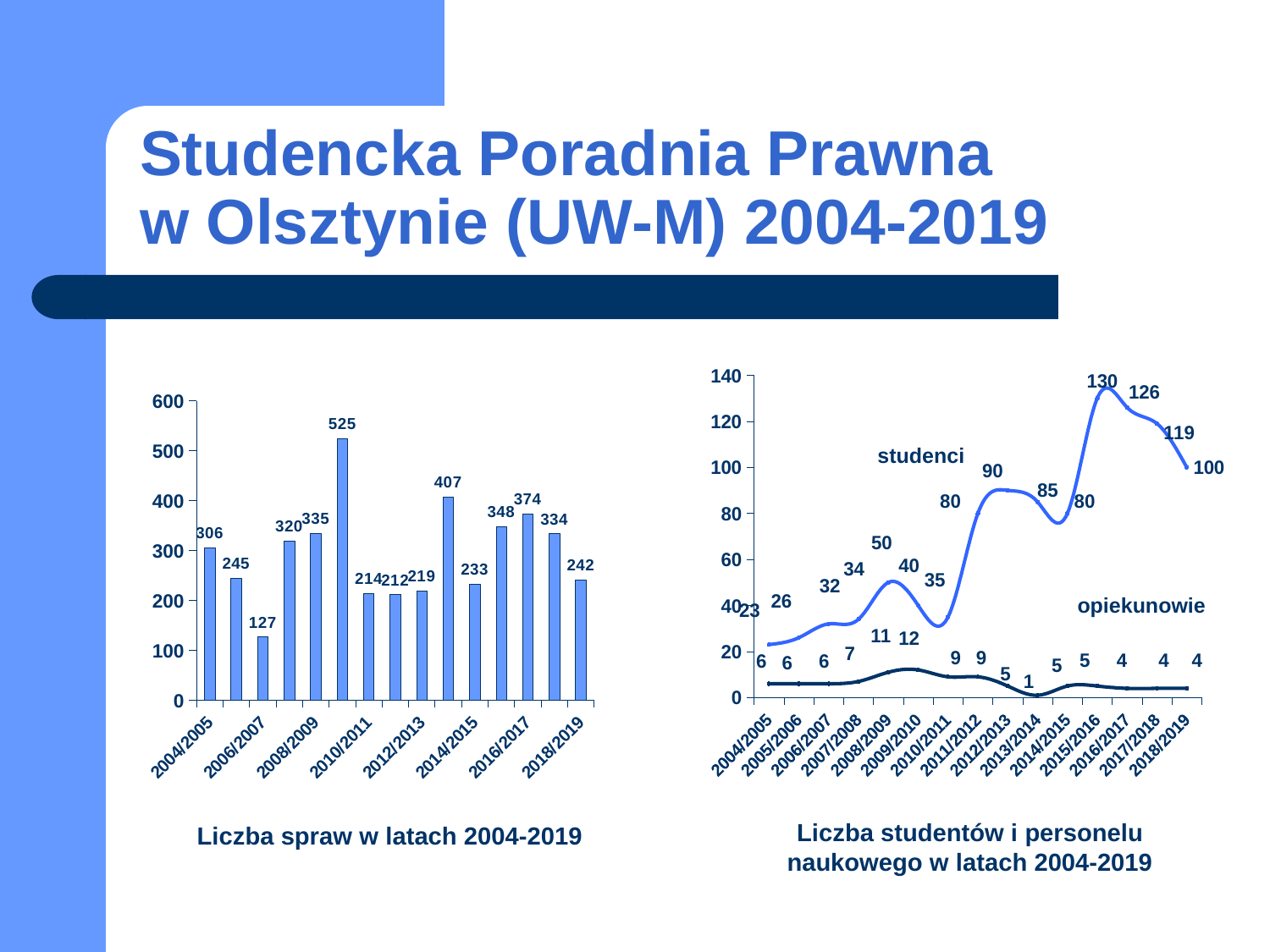
What kind of chart is the right chart, 'Liczba studentów i personelu naukowego w latach 2004-2019'? line chart In the left chart 'Liczba spraw w latach 2004-2019', what is the value for 2018/2019? 242 In the right chart 'Liczba studentów i personelu naukowego w latach 2004-2019', what is the difference between studenci and opiekunowie in 2018/2019? 96 What kind of chart is the left chart, 'Liczba spraw w latach 2004-2019'? bar chart How many series are plotted in the right chart 'Liczba studentów i personelu naukowego w latach 2004-2019'? 2 How many bars are in the left chart 'Liczba spraw w latach 2004-2019'? 15 In the left chart 'Liczba spraw w latach 2004-2019', what is the value for 2004/2005? 306 In the right chart 'Liczba studentów i personelu naukowego w latach 2004-2019', what is the value for opiekunowie in 2013/2014? 1 In the left chart 'Liczba spraw w latach 2004-2019', what is the difference between the values for 2016/2017 and 2014/2015? 141 In the right chart 'Liczba studentów i personelu naukowego w latach 2004-2019', what is the value for studenci in 2015/2016? 130 In the left chart 'Liczba spraw w latach 2004-2019', which year has the lowest value? 2006/2007 In the left chart 'Liczba spraw w latach 2004-2019', what is the highest value shown? 525